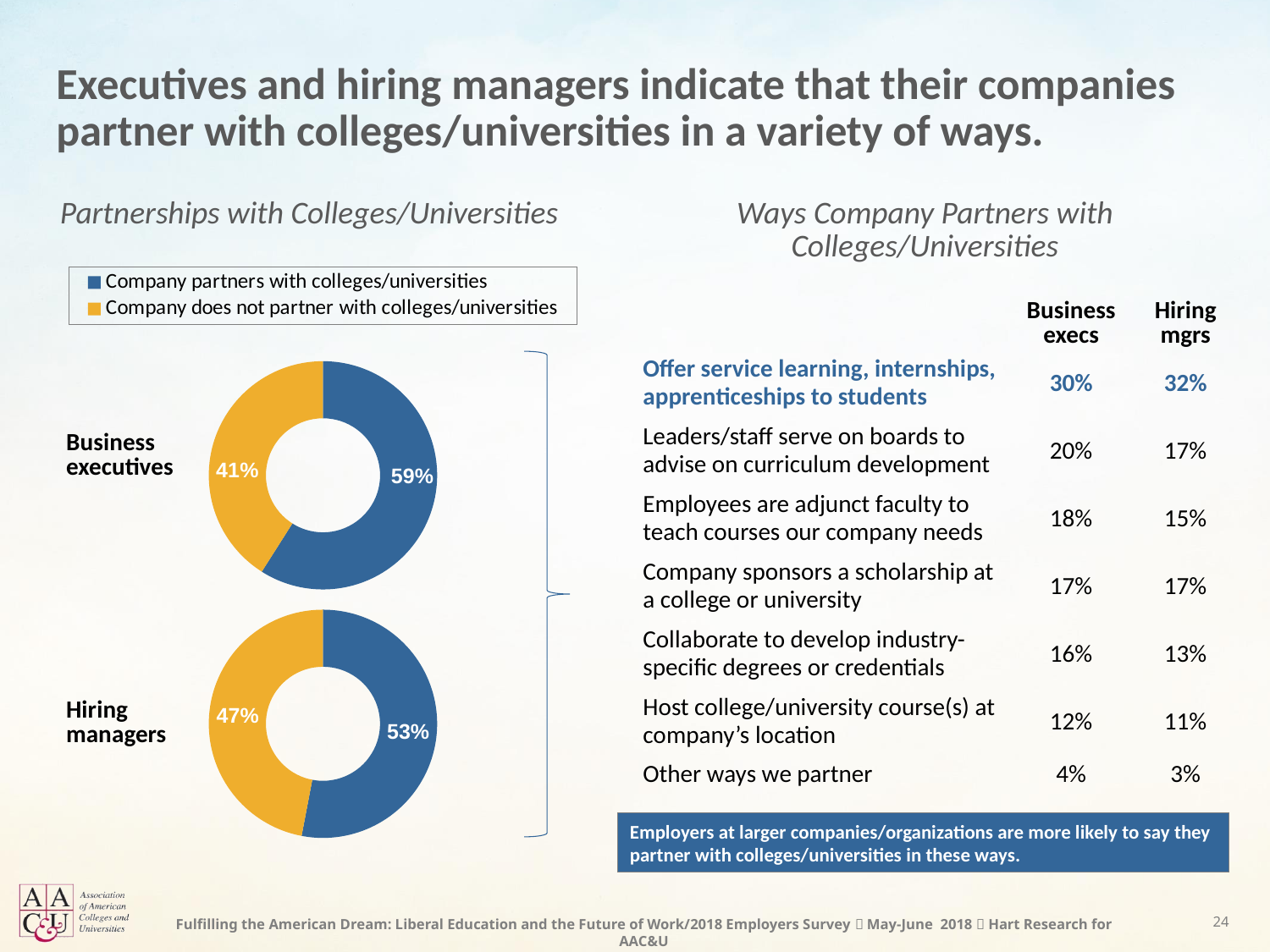
In the Hiring managers donut chart, what percentage of companies do not partner with colleges/universities? 47% In the Business executives donut chart, which slice is larger: partners or does not partner? Company partners with colleges/universities In the Hiring managers donut chart, what is the difference between the partners slice and the does-not-partner slice? 6% In the Business executives donut chart, what percentage of companies do not partner with colleges/universities? 41% How many entries does the legend for the donut charts list? 2 In the Hiring managers donut chart, what percentage of companies partner with colleges/universities? 53% In the Business executives donut chart, what is the difference between the partners slice and the does-not-partner slice? 18% In the donut charts, which colour represents 'Company does not partner with colleges/universities'? Yellow/orange In the Business executives donut chart, what percentage of companies partner with colleges/universities? 59% What type of chart is used under the heading 'Partnerships with Colleges/Universities'? Donut (pie) chart In the Hiring managers donut chart, which slice is the smallest? Company does not partner with colleges/universities Comparing the two donut charts, which group has the higher share of companies that partner with colleges/universities: Business executives or Hiring managers? Business executives